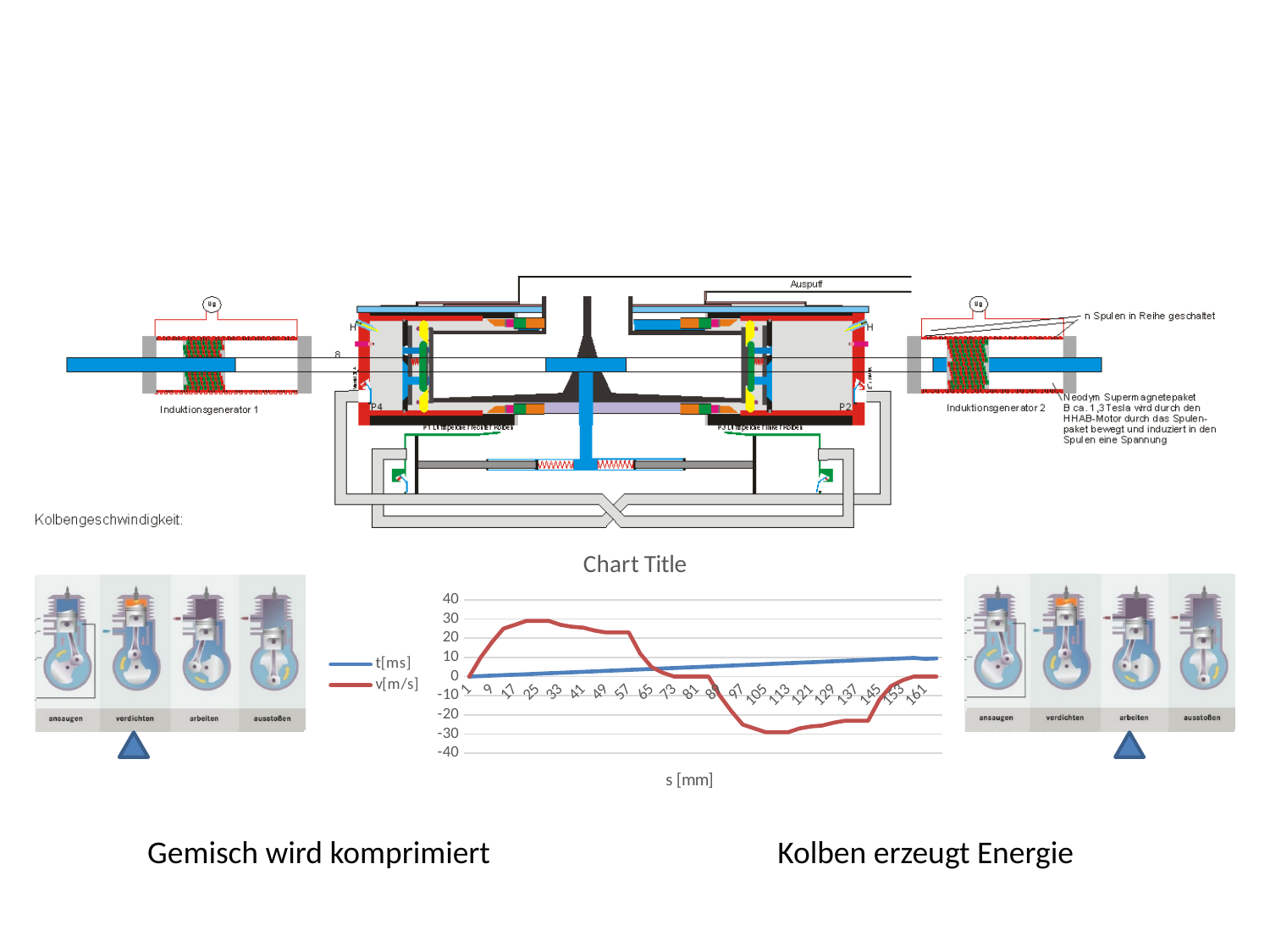
Which is larger, the value of v[m/s] at s = 25 or at s = 105? s = 25 Is the value of v[m/s] at s = 129 greater or less than 0? less What kind of chart is shown on the slide? line chart Is the value of v[m/s] at s = 17 greater or less than 10? greater Is the value of v[m/s] at s = 41 greater or less than 20? greater Which is larger at s = 121, the value of t[ms] or the value of v[m/s]? t[ms] Does the t[ms] series rise or fall as s increases along the x axis? rise What is the label of the chart's x axis? s [mm] How many series does the chart legend list? 2 What are the two series named in the chart legend? t[ms] and v[m/s]